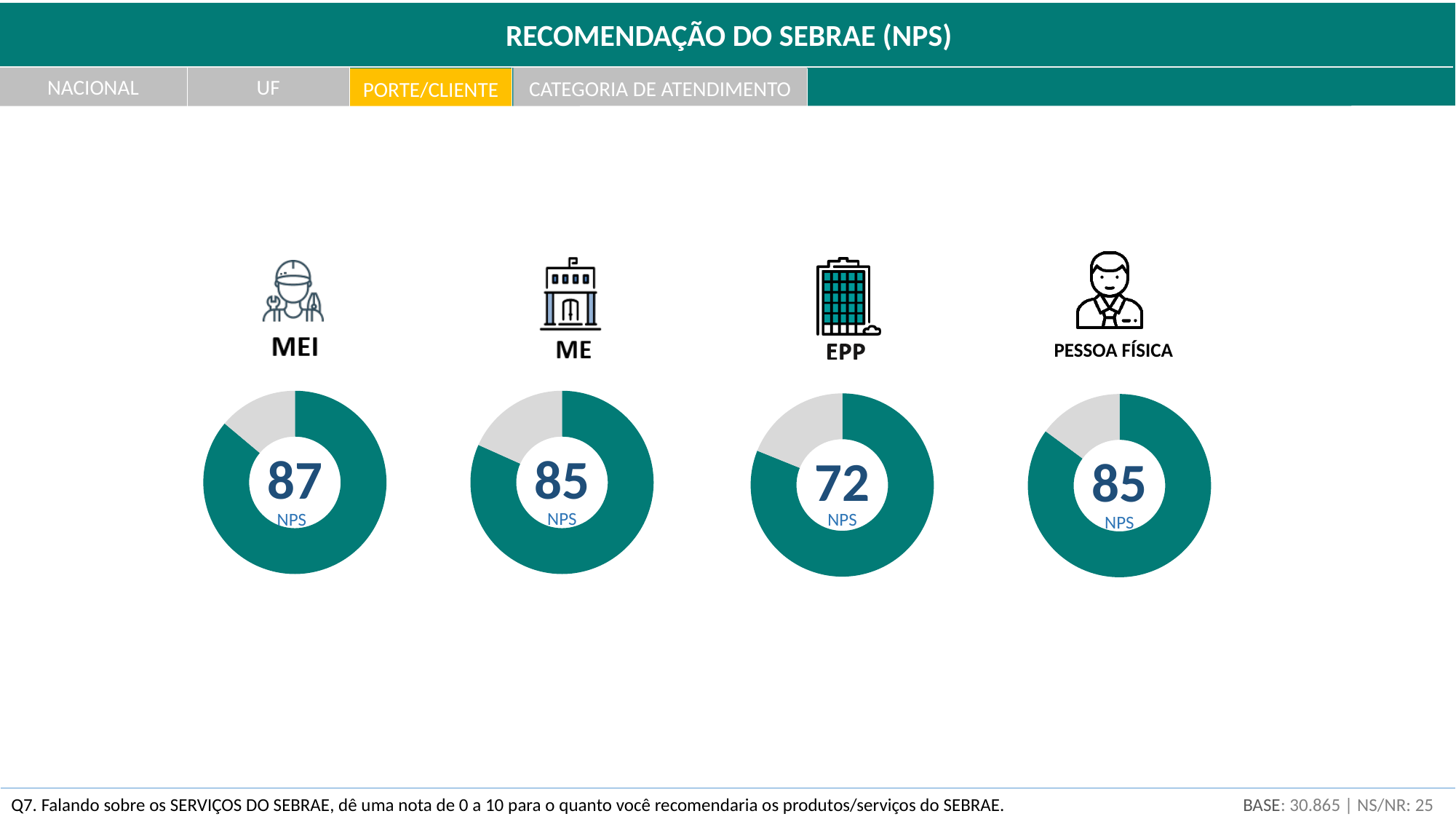
What is the difference between the NPS of MEI and the NPS of EPP? 15 Which group has the highest NPS among the four donut charts? MEI Which tab is highlighted in yellow below the slide title? PORTE/CLIENTE What is the NPS value shown in the EPP donut chart? 72 How many donut charts are shown on the slide? 4 What is the NPS value shown in the MEI donut chart? 87 What is the NPS value shown in the PESSOA FÍSICA donut chart? 85 What is the NPS value shown in the ME donut chart? 85 What is the difference between the NPS of ME and the NPS of EPP? 13 Which group has the lowest NPS among the four donut charts? EPP What kind of chart is used to display each NPS value? Donut chart Which has a higher NPS, MEI or ME? MEI